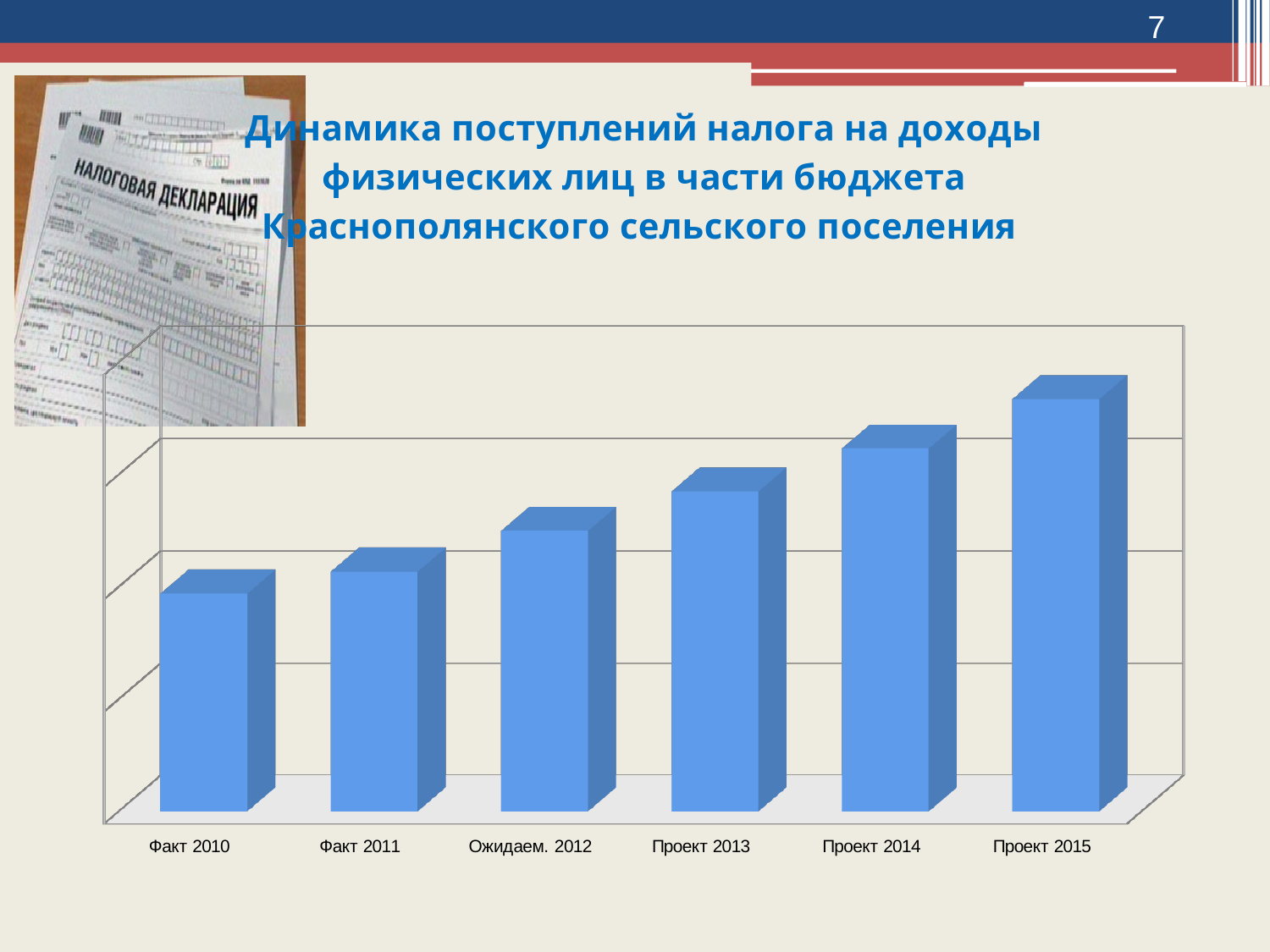
What is the label of the first category on the x axis? Факт 2010 How many categories are shown on the x axis of the chart? 6 What is the label of the third category on the x axis? Ожидаем. 2012 Which is larger, the bar for Факт 2011 or the bar for Проект 2013? Проект 2013 What kind of chart is shown on the slide? bar chart Which category has the highest bar in the chart? Проект 2015 Which is larger, the bar for Проект 2014 or the bar for Ожидаем. 2012? Проект 2014 Which category has the lowest bar in the chart? Факт 2010 Do the bar values rise or fall from Факт 2010 to Проект 2015? rise